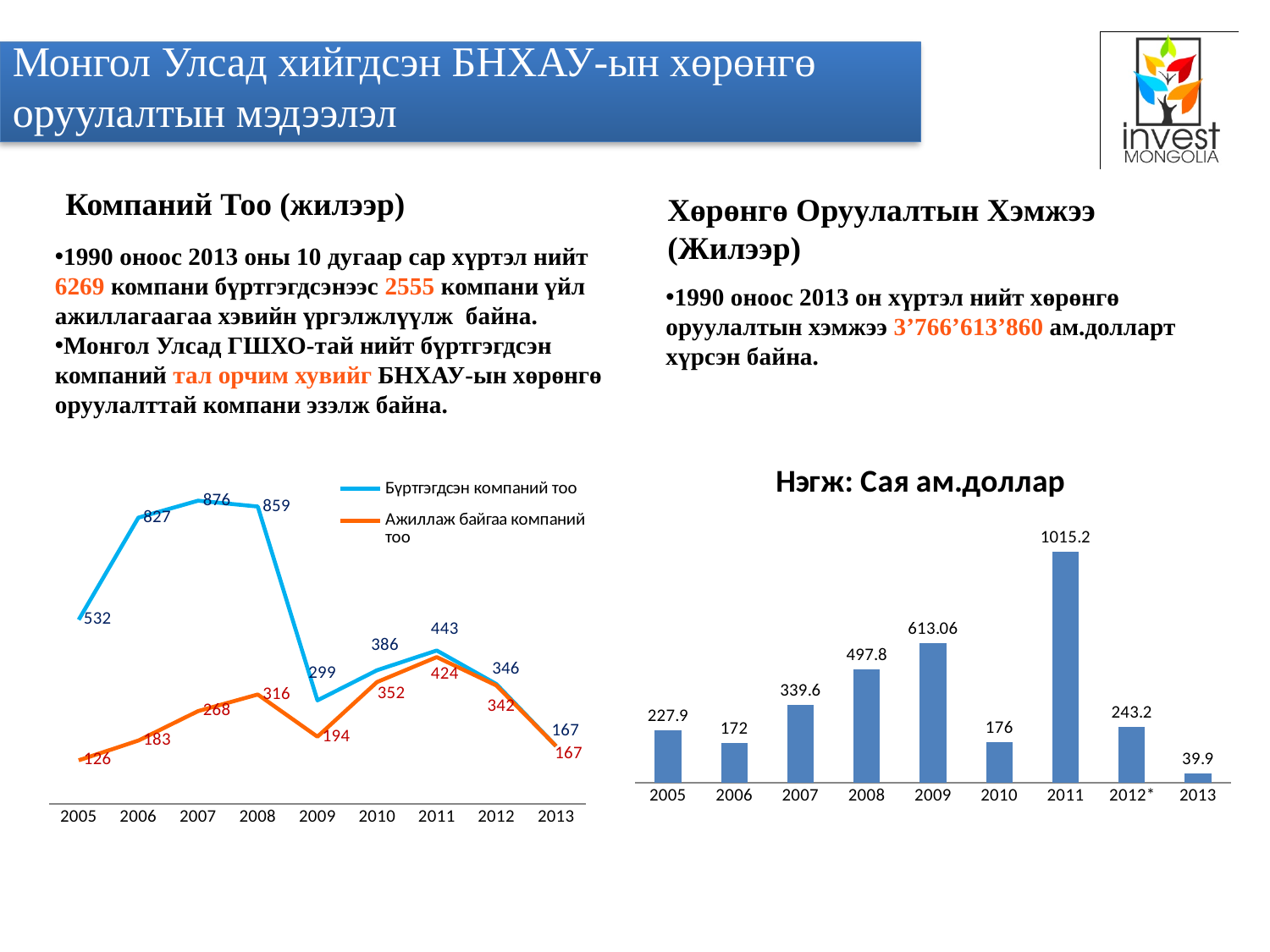
In the line chart on the left, what is the difference between 'Бүртгэгдсэн компаний тоо' and 'Ажиллаж байгаа компаний тоо' in 2008? 543 In the line chart on the left, which year has the lowest value for 'Ажиллаж байгаа компаний тоо'? 2005 In the line chart on the left, how many series does the legend list? 2 What kind of chart is the chart on the right of the slide? Bar chart In the bar chart titled 'Нэгж: Сая ам.доллар', which year has the highest value? 2011 In the bar chart titled 'Нэгж: Сая ам.доллар', what is the value for 2011? 1015.2 In the bar chart titled 'Нэгж: Сая ам.доллар', which year has the lowest value? 2013 In the bar chart titled 'Нэгж: Сая ам.доллар', how many years are shown on the x axis? 9 In the line chart on the left, what is the value of 'Ажиллаж байгаа компаний тоо' for 2011? 424 In the line chart on the left, what is the value of 'Бүртгэгдсэн компаний тоо' for 2007? 876 In the bar chart titled 'Нэгж: Сая ам.доллар', what is the difference between the values for 2009 and 2010? 437.06 In the line chart on the left, is the value of 'Бүртгэгдсэн компаний тоо' larger in 2006 or in 2009? 2006